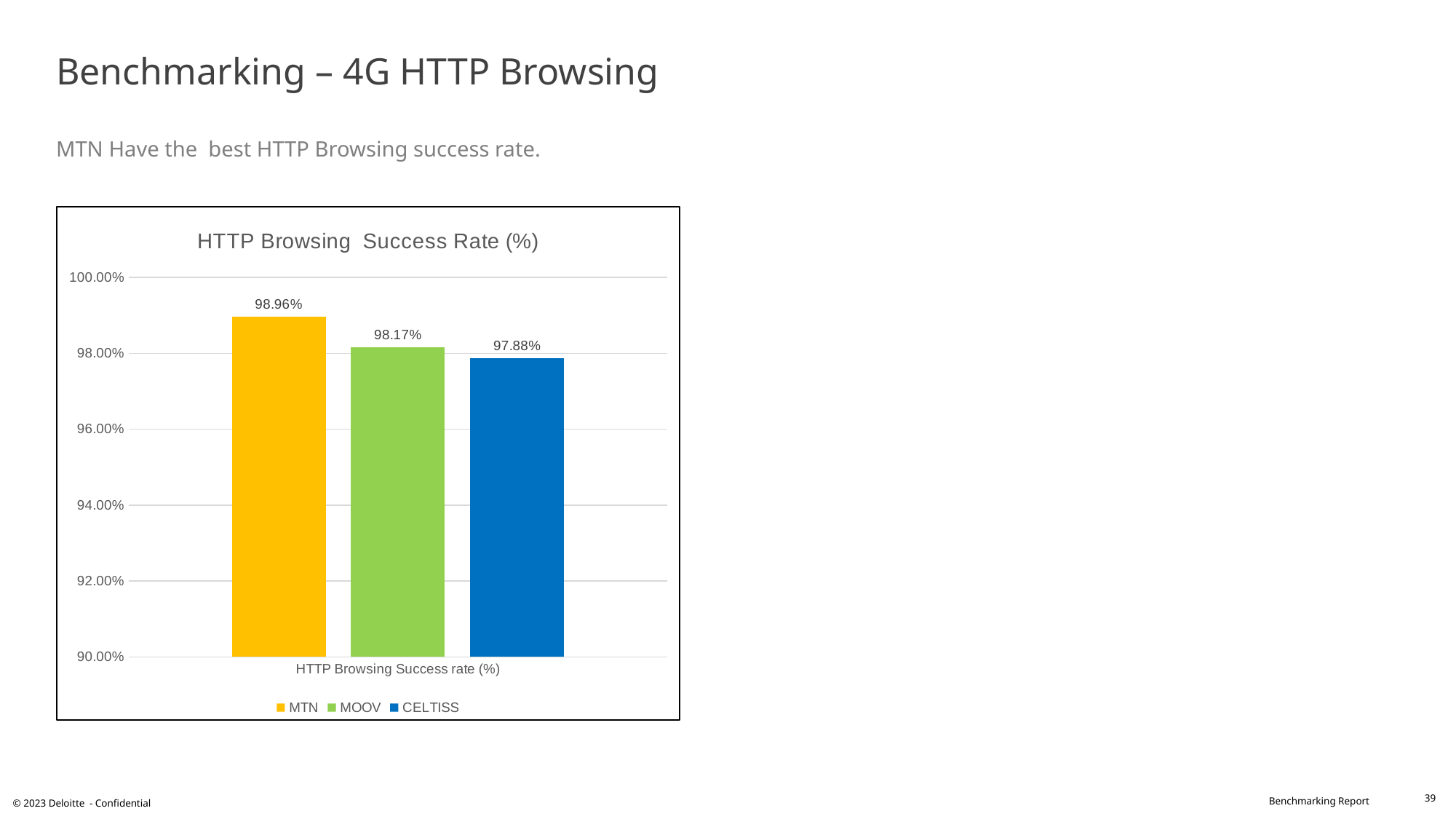
What is the difference between MOOV's and CELTISS's HTTP Browsing success rates? 0.29% Which operator has the lowest HTTP Browsing success rate? CELTISS What is the title of the chart? HTTP Browsing Success Rate (%) Is the value for CELTISS greater or less than 98.00%? less What is the HTTP Browsing success rate for CELTISS? 97.88% Which operator has the highest HTTP Browsing success rate? MTN Which has a higher HTTP Browsing success rate, MOOV or CELTISS? MOOV What is the HTTP Browsing success rate for MOOV? 98.17% What kind of chart is shown on the slide? bar chart What is the difference between MTN's and CELTISS's HTTP Browsing success rates? 1.08% What is the HTTP Browsing success rate for MTN? 98.96% How many series does the legend list? 3